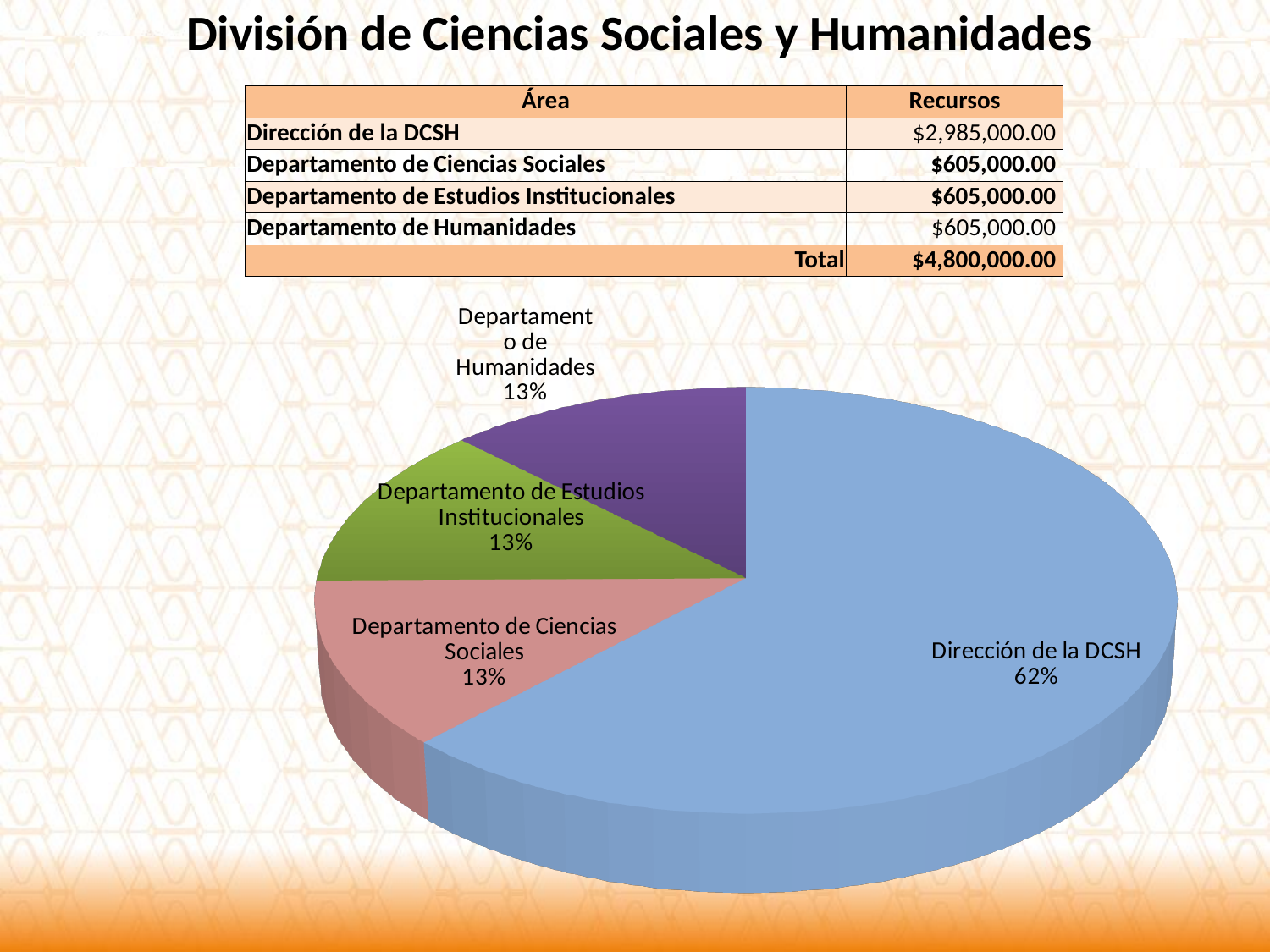
What colour is the Departamento de Humanidades slice in the pie chart? purple What share of the pie does Departamento de Humanidades represent? 13% Which slice of the pie chart is the largest? Dirección de la DCSH What share of the pie does Departamento de Ciencias Sociales represent? 13% What colour is the Dirección de la DCSH slice in the pie chart? blue Which is larger in the pie chart, the slice for Dirección de la DCSH or the slice for Departamento de Humanidades? Dirección de la DCSH What share of the pie does Departamento de Estudios Institucionales represent? 13% How many slices does the pie chart have? 4 What kind of chart is shown on the slide? pie chart Is the share for Dirección de la DCSH greater or less than 50%? greater What is the difference in percentage points between the Dirección de la DCSH slice and the Departamento de Ciencias Sociales slice? 49 percentage points